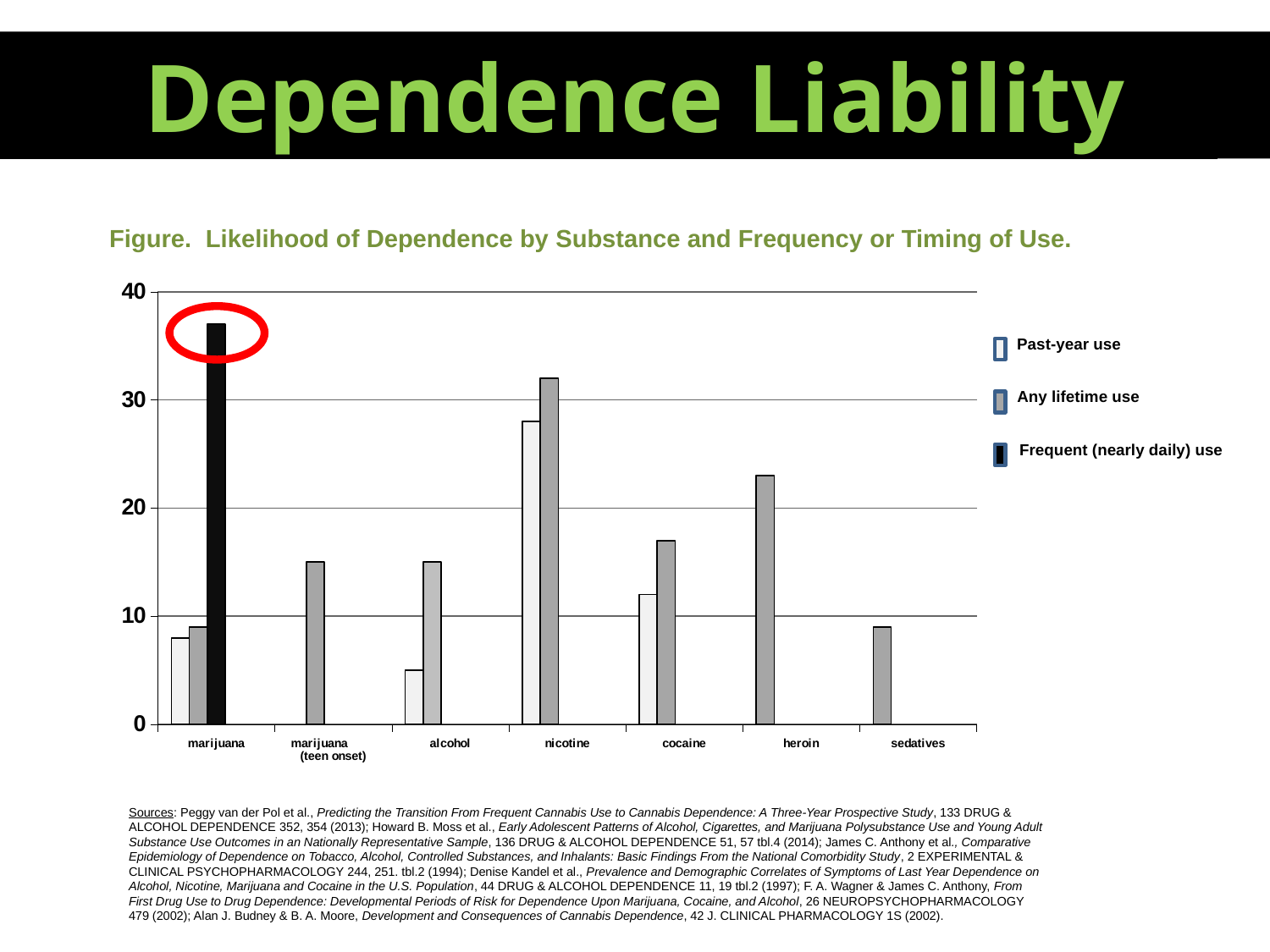
Is the Past-year use value for alcohol greater or less than 10? less Which substance is the only one with a bar for Frequent (nearly daily) use? marijuana Which substance has the lowest value for Past-year use? alcohol Which substance has the highest value for Any lifetime use? nicotine Is the Any lifetime use value for heroin greater or less than 20? greater Is the Frequent (nearly daily) use value for marijuana greater or less than 30? greater Which substance has the tallest bar in the chart? marijuana What kind of chart is shown on the slide? bar chart How many series does the legend list? 3 How many substance categories are shown on the x axis? 7 Which is larger: the Any lifetime use value for heroin or for cocaine? heroin